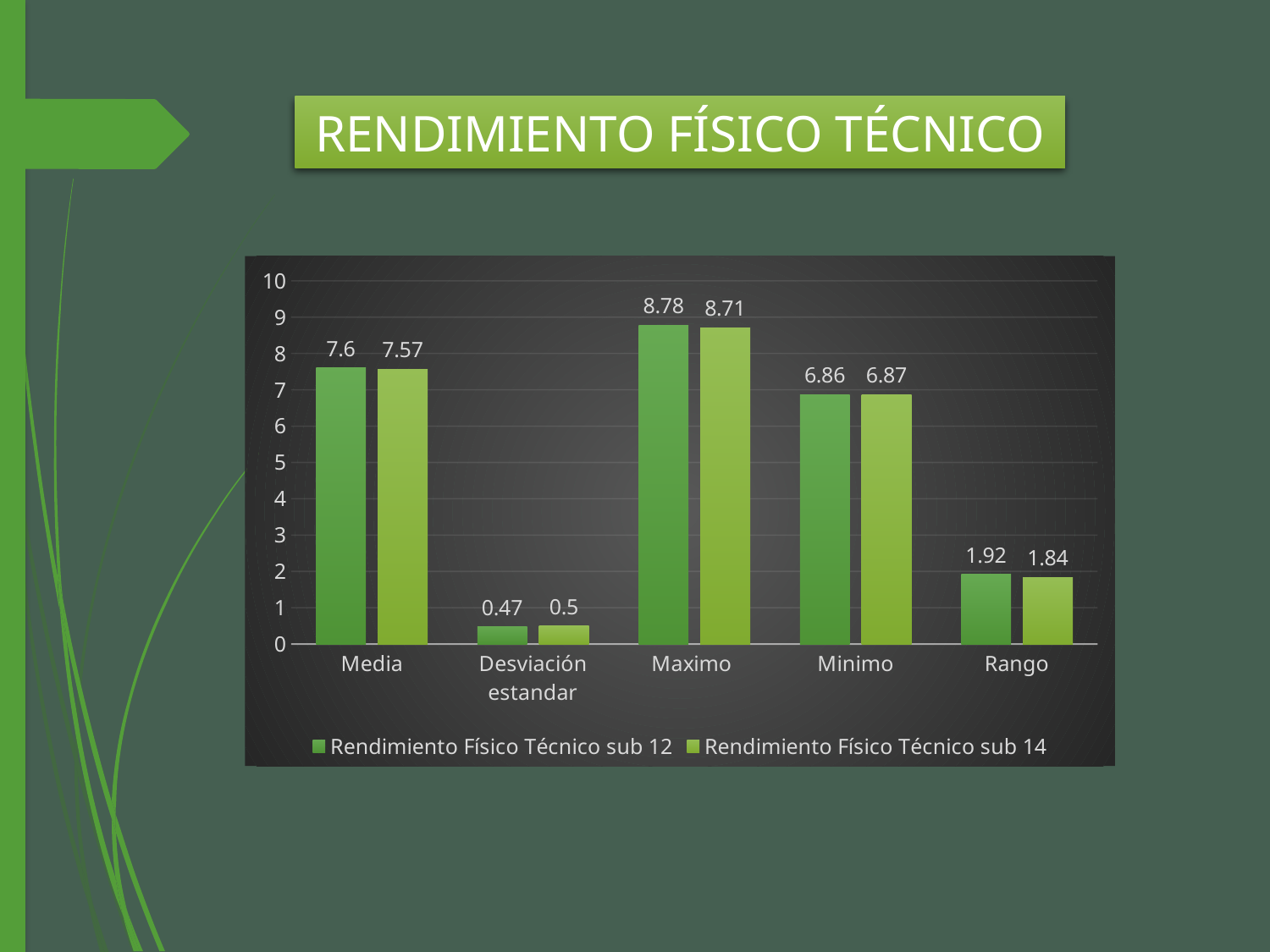
What is the value of Rendimiento Físico Técnico sub 12 for Media? 7.6 What is the value of Rendimiento Físico Técnico sub 12 for Rango? 1.92 Which category has the highest value for Rendimiento Físico Técnico sub 12? Maximo What is the difference between the sub 12 and sub 14 values for Rango? 0.08 What kind of chart is shown on the slide? Bar chart How many series does the legend list? 2 Which is larger for Rango: Rendimiento Físico Técnico sub 12 or sub 14? Rendimiento Físico Técnico sub 12 What is the value of Rendimiento Físico Técnico sub 14 for Maximo? 8.71 What is the difference between the Maximo and Minimo values for Rendimiento Físico Técnico sub 12? 1.92 What is the value of Rendimiento Físico Técnico sub 14 for Desviación estandar? 0.5 How many categories are shown on the x axis? 5 Which category has the lowest value for Rendimiento Físico Técnico sub 14? Desviación estandar